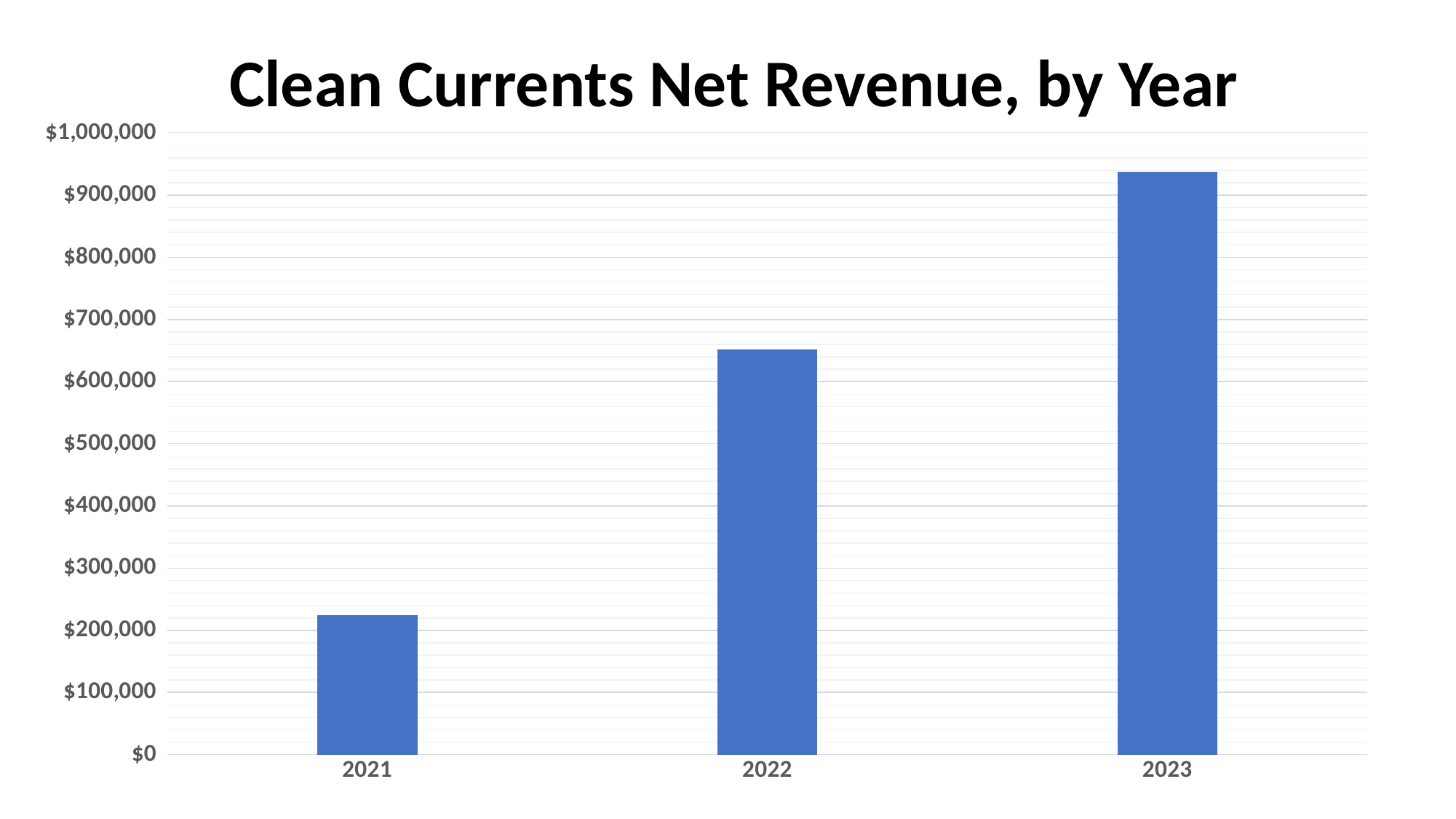
Is the net revenue for 2021 greater or less than $300,000? less How many years are shown on the x axis of the chart? 3 Is the net revenue for 2021 greater or less than $200,000? greater Is the net revenue for 2023 greater or less than $900,000? greater Does net revenue rise or fall from 2021 to 2023? rise Which year has the lowest net revenue? 2021 What is the title of the chart? Clean Currents Net Revenue, by Year Which year has the highest net revenue? 2023 What type of chart is shown on the slide? bar chart Which year has the larger net revenue, 2021 or 2022? 2022